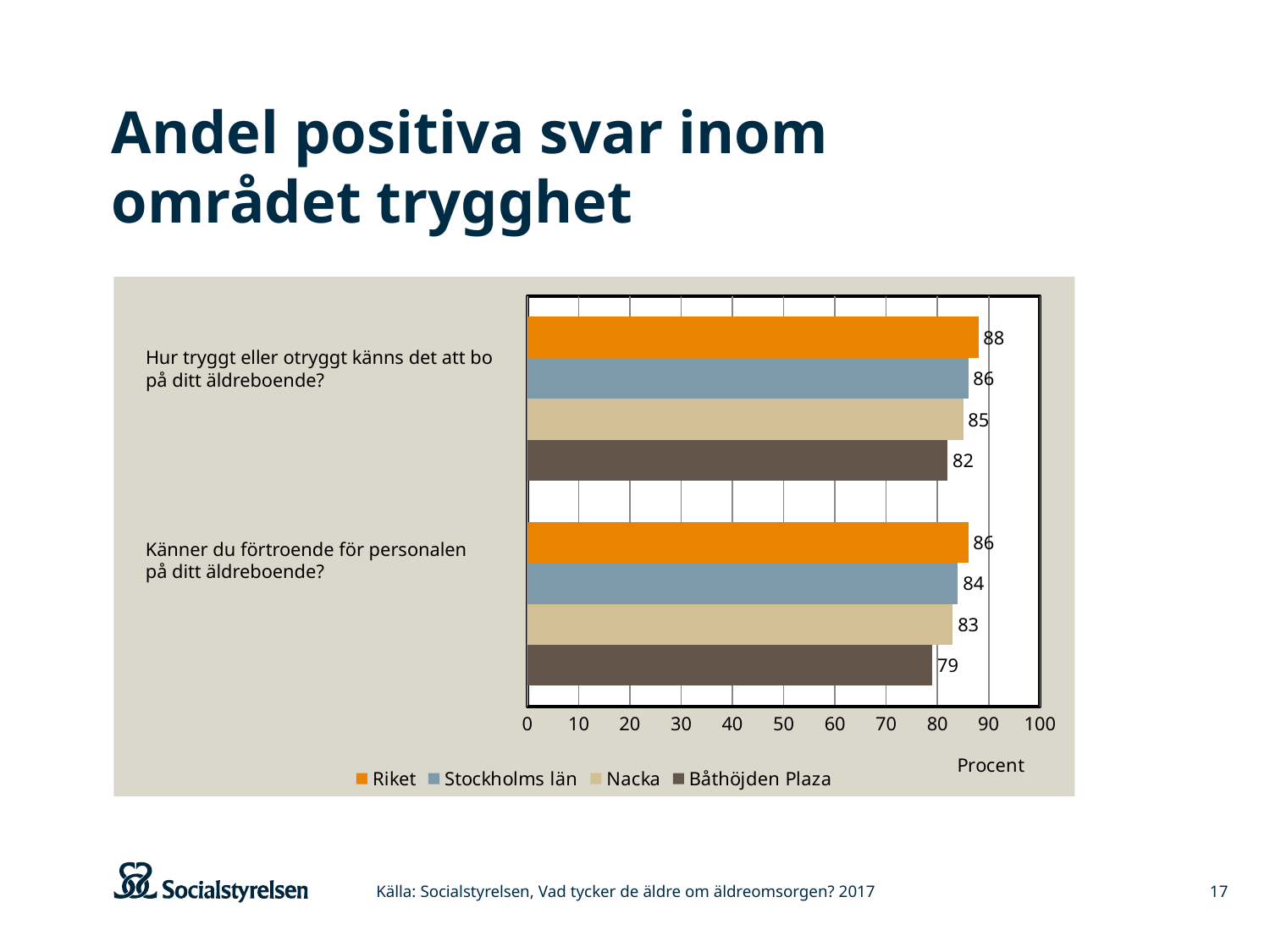
What kind of chart is shown on the slide? Bar chart Which is larger: Nacka on "Hur tryggt eller otryggt känns det att bo på ditt äldreboende?" or Nacka on "Känner du förtroende för personalen på ditt äldreboende?"? Hur tryggt eller otryggt känns det att bo på ditt äldreboende? What is the value for Båthöjden Plaza on the question "Känner du förtroende för personalen på ditt äldreboende?"? 79 What is the value for Riket on the question "Hur tryggt eller otryggt känns det att bo på ditt äldreboende?"? 88 What is the value for Nacka on the question "Hur tryggt eller otryggt känns det att bo på ditt äldreboende?"? 85 What is the label on the horizontal axis of the chart? Procent What is the difference between Riket and Båthöjden Plaza on the question "Känner du förtroende för personalen på ditt äldreboende?"? 7 Which series has the highest value on the question "Känner du förtroende för personalen på ditt äldreboende?"? Riket Which series has the lowest value on the question "Hur tryggt eller otryggt känns det att bo på ditt äldreboende?"? Båthöjden Plaza Is the value for Båthöjden Plaza on "Känner du förtroende för personalen på ditt äldreboende?" greater or less than 80? less What is the value for Stockholms län on the question "Känner du förtroende för personalen på ditt äldreboende?"? 84 How many series does the legend list? 4